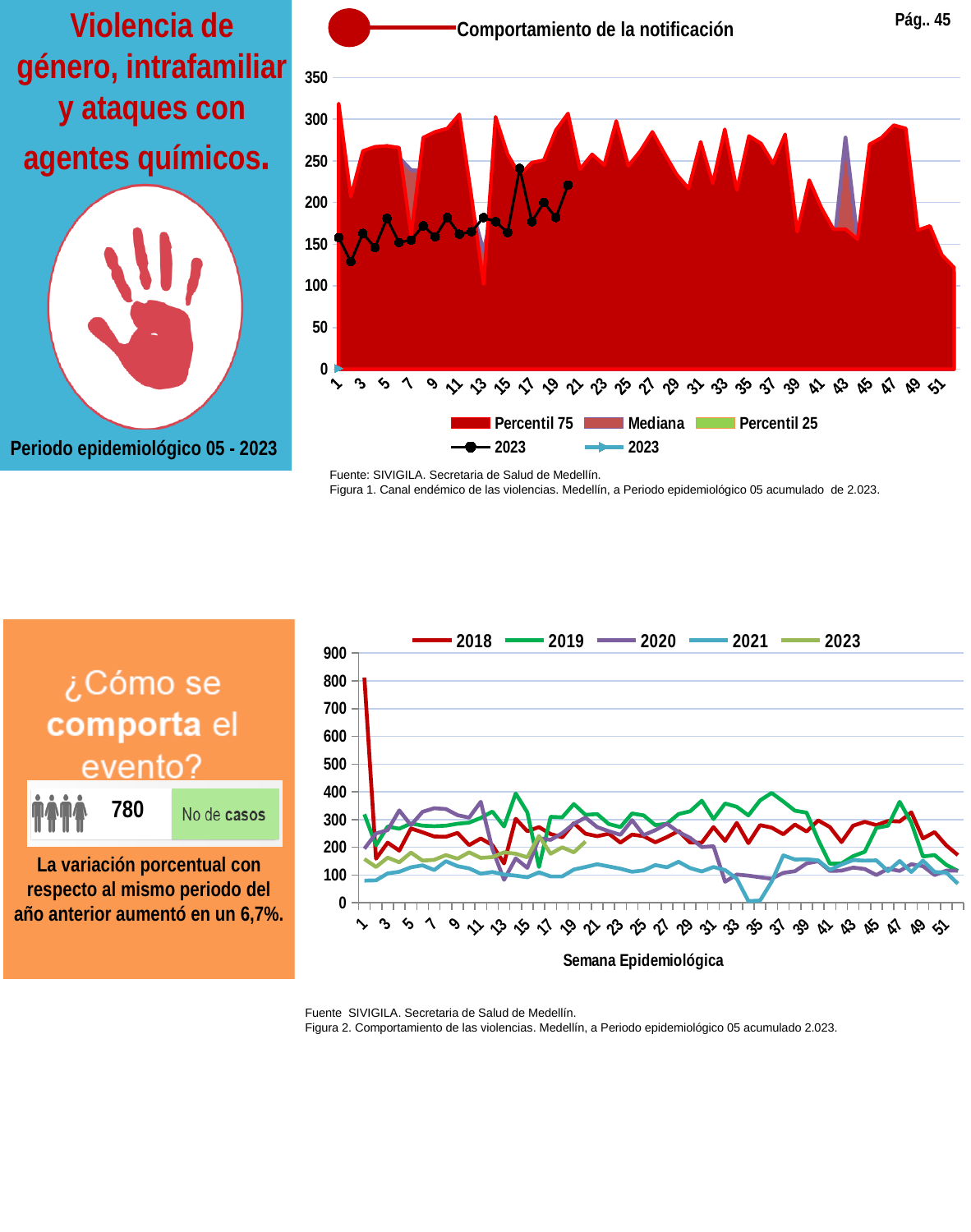
In the top chart "Comportamiento de la notificación", is the 2023 value at week 16 greater or less than 200? greater What is the x-axis title of the bottom chart? Semana Epidemiológica In the top chart "Comportamiento de la notificación", is the 2023 value at week 1 greater or less than 200? less In the bottom chart, is the 2018 value at week 1 greater or less than 700? greater How many series does the legend of the bottom chart list? 5 How many entries does the legend of the top chart "Comportamiento de la notificación" list? 5 What kind of chart is the top chart titled "Comportamiento de la notificación"? area chart What kind of chart is the bottom chart with the x-axis "Semana Epidemiológica"? line chart What is the highest value shown on the y-axis of the bottom chart? 900